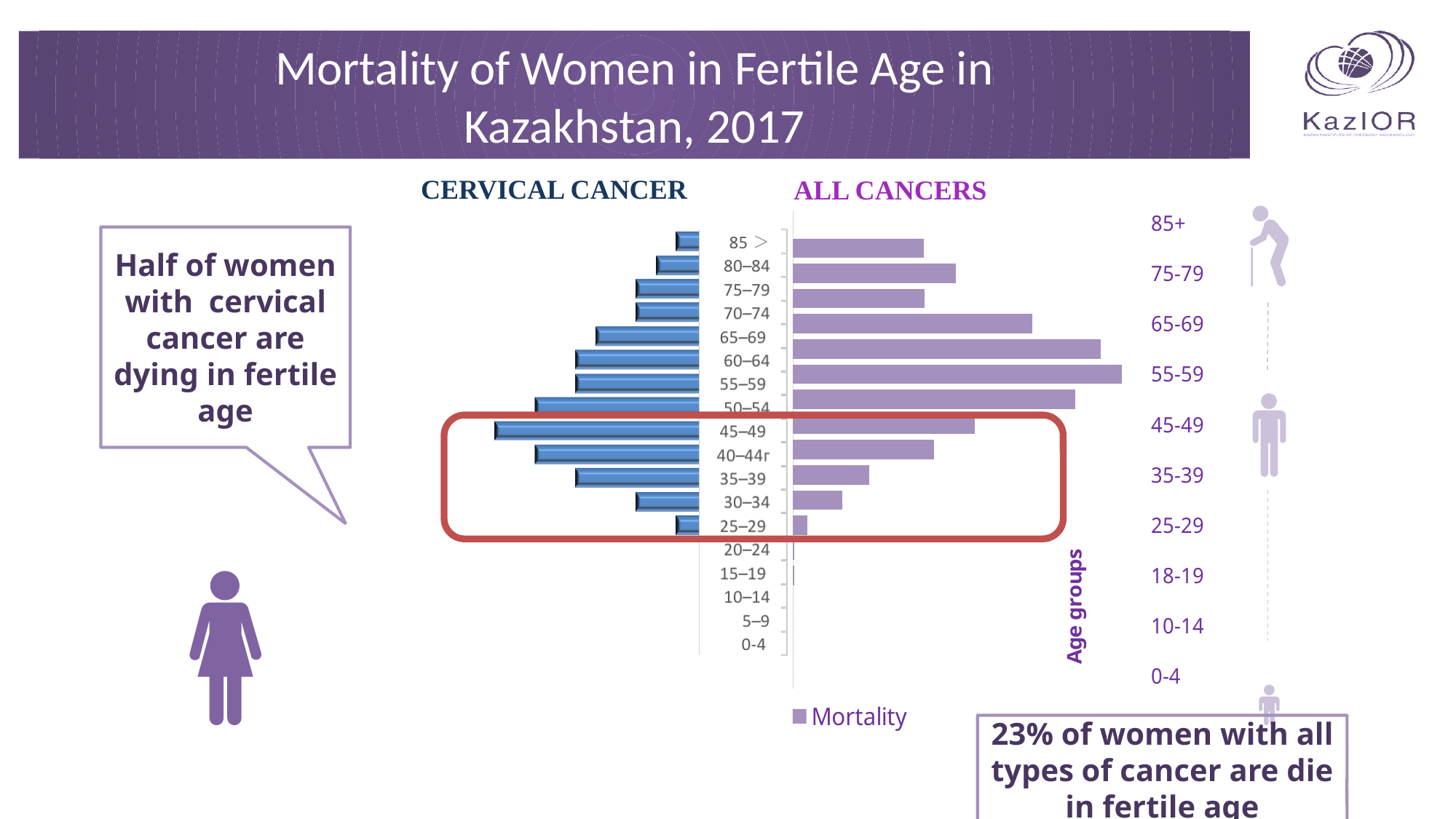
In the Cervical Cancer chart, do the bars get longer or shorter going from the 45–49 age group down to the 25–29 age group? shorter In the Cervical Cancer chart, which age group has the longest bar? 45–49 What is the legend entry shown under the All Cancers chart? Mortality What colour are the bars in the Cervical Cancer chart? blue How many age groups are listed on the axis between the two charts? 18 In the Cervical Cancer chart, which bar is longer: 40–44 or 30–34? 40–44 How many series does the legend under the All Cancers chart list? 1 What kind of chart is used to show cervical cancer and all cancers mortality by age group? bar chart In the Cervical Cancer chart, which bar is longer: 45–49 or 25–29? 45–49 In the All Cancers chart, which age group has the longest bar? 55–59 In the All Cancers chart, do the bars get longer or shorter going from the 25–29 age group up to the 55–59 age group? longer In the All Cancers chart, which bar is longer: 65–69 or 35–39? 65–69